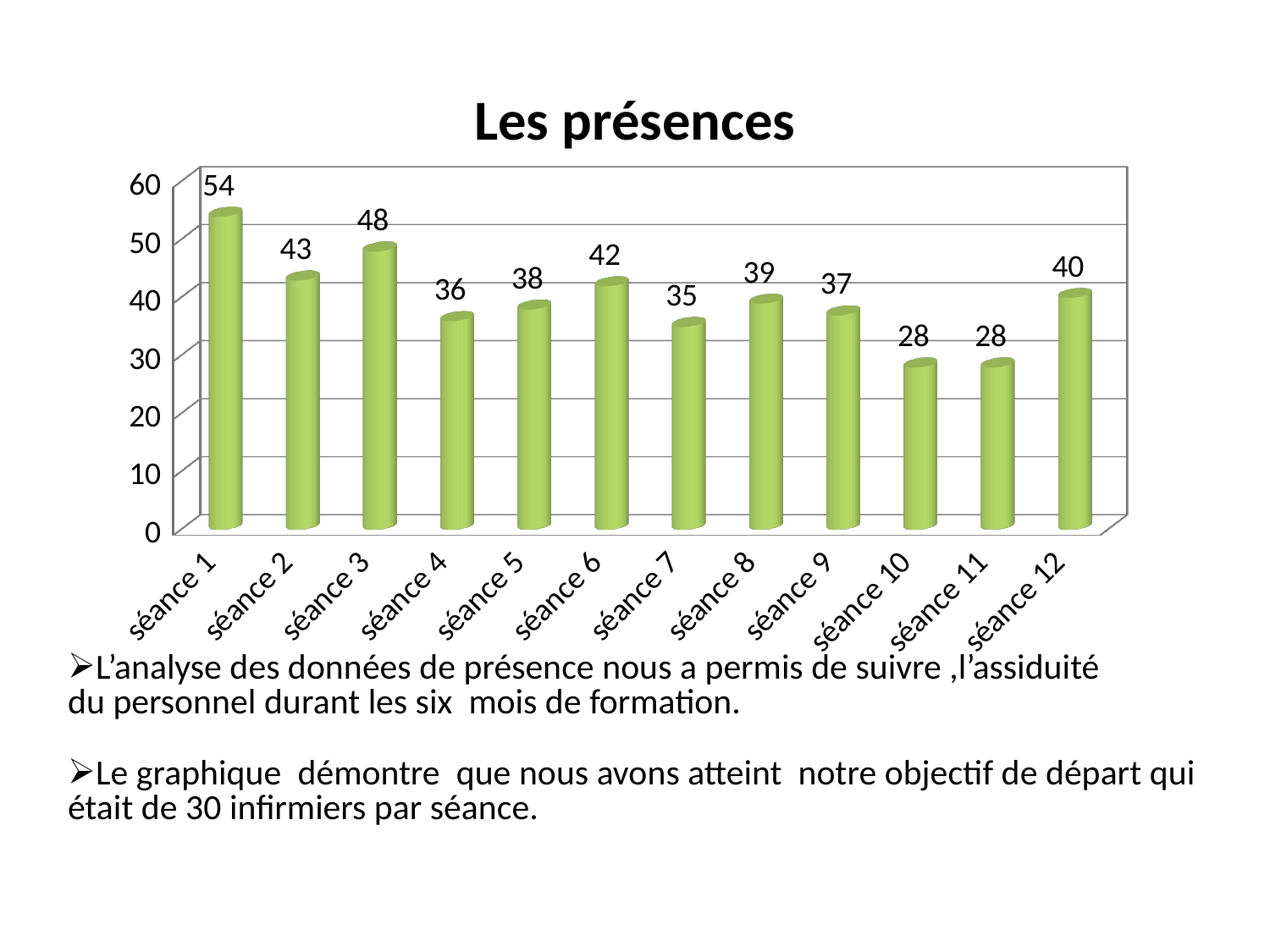
What is the difference between the values for séance 1 and séance 3? 6 Which séance has the highest value? séance 1 Which is larger, the value for séance 5 or the value for séance 9? séance 5 What is the value for séance 12? 40 What is the value for séance 1? 54 What is the value for séance 7? 35 How many séances are shown on the chart? 12 Is the value for séance 10 greater or less than 30? less What is the lowest value shown on the chart? 28 What is the difference between the values for séance 12 and séance 11? 12 What kind of chart is shown on the slide? bar chart What is the title of the chart? Les présences